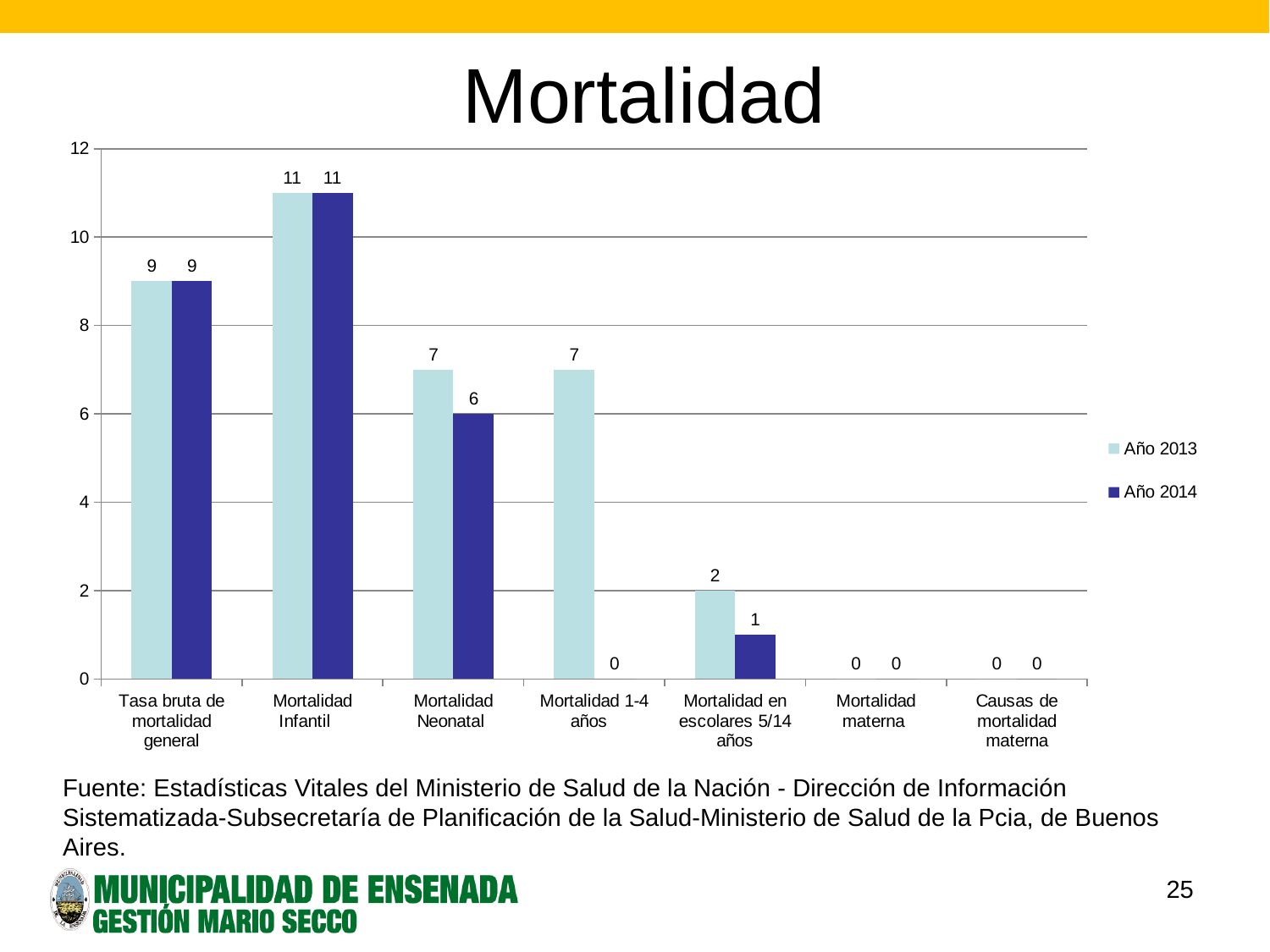
What kind of chart is shown on the slide? Bar chart What is the value for Mortalidad en escolares 5/14 años in Año 2013? 2 What is the difference between the Año 2013 and Año 2014 values for Mortalidad Neonatal? 1 What is the value for Mortalidad 1-4 años in Año 2014? 0 How many categories are shown on the x axis? 7 What is the value for Mortalidad Infantil in Año 2013? 11 What is the value for Mortalidad Neonatal in Año 2014? 6 Which category has the highest value in Año 2014? Mortalidad Infantil What is the difference between the Año 2013 and Año 2014 values for Mortalidad 1-4 años? 7 How many series does the legend list? 2 What is the title of the slide? Mortalidad Which is larger for Mortalidad en escolares 5/14 años: the Año 2013 value or the Año 2014 value? Año 2013